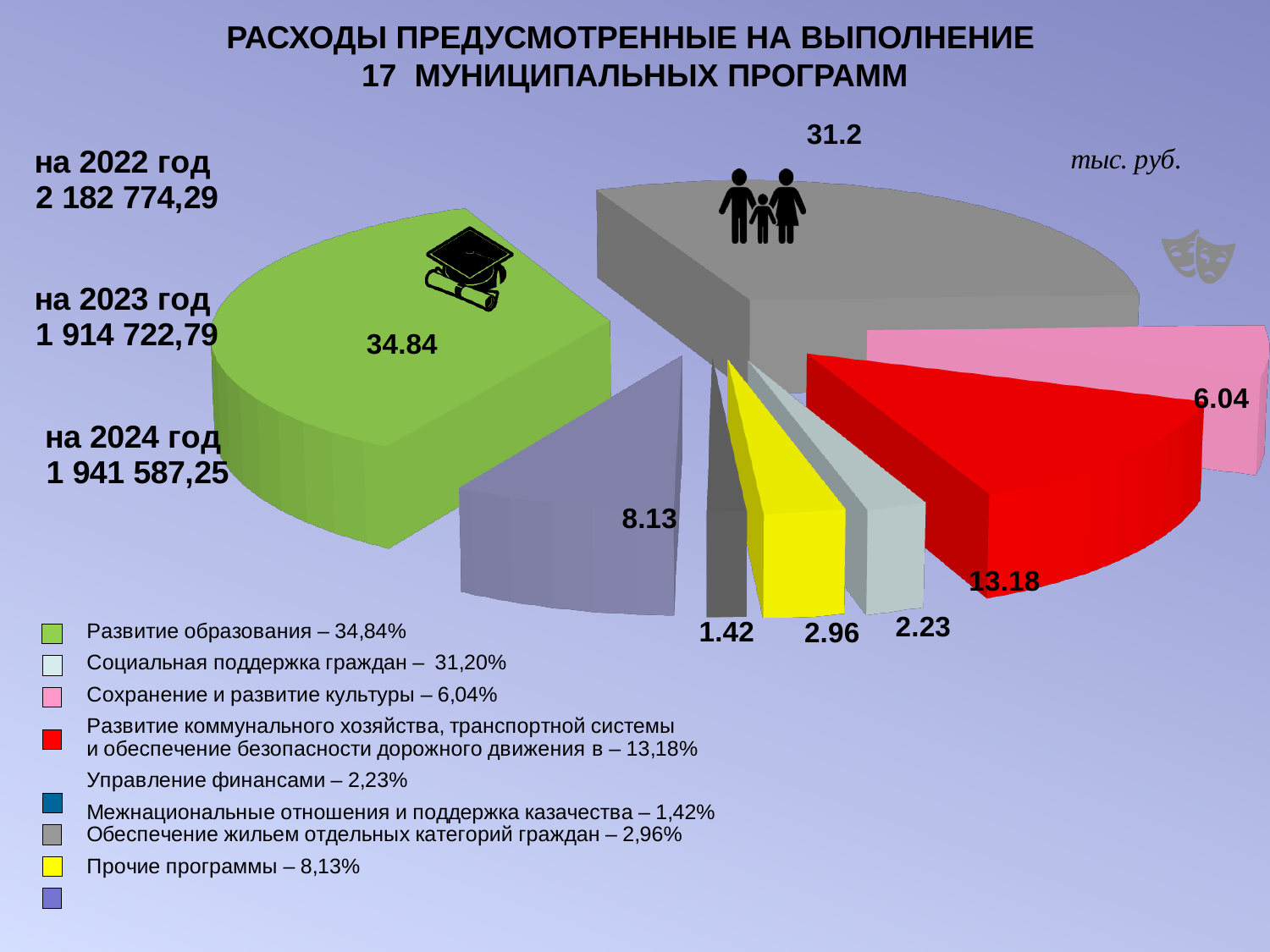
What is the difference between the Развитие образования slice (34.84) and the Социальная поддержка граждан slice (31.2)? 3.64 Which program has the largest share of the pie chart? Развитие образования What value is labelled on the slice for Социальная поддержка граждан? 31.2 Which is larger: the slice for Управление финансами or the slice for Обеспечение жильем отдельных категорий граждан? Обеспечение жильем отдельных категорий граждан What share of the pie does the Развитие коммунального хозяйства, транспортной системы и обеспечение безопасности дорожного движения slice represent, according to the legend? 13,18% What value is labelled on the slice for Развитие образования? 34.84 Which program has the smallest share of the pie chart? Межнациональные отношения и поддержка казачества What kind of chart is shown on the slide? pie chart What value is labelled on the slice for Сохранение и развитие культуры? 6.04 What unit is indicated in the top right corner of the chart? тыс. руб. How many slices does the pie chart have? 8 What value is labelled on the slice for Прочие программы? 8.13